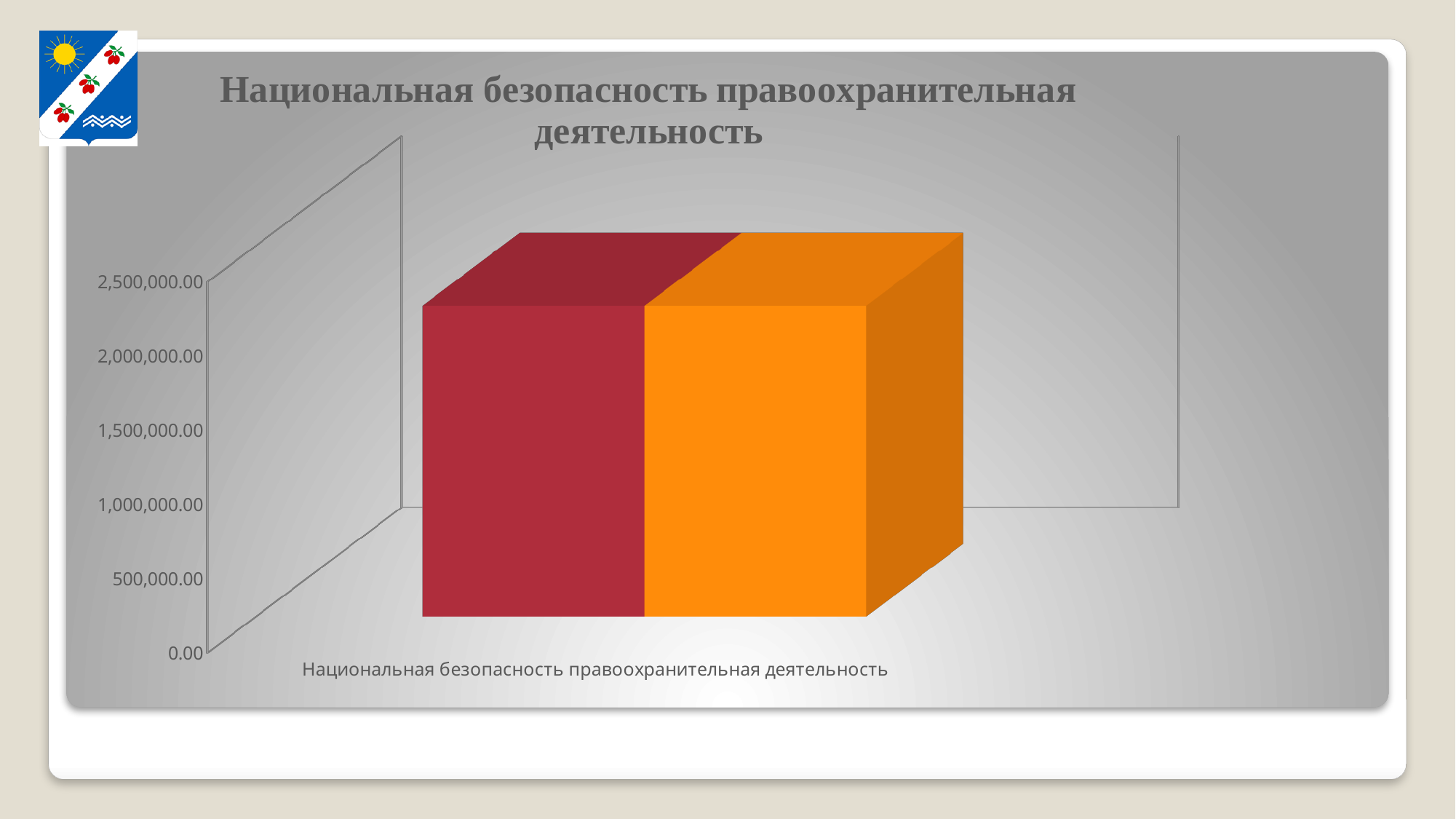
Does the chart display a legend? No How many categories are shown on the x axis of the chart? 1 What is the category label shown on the x axis? Национальная безопасность правоохранительная деятельность Is the value of the orange bar greater or less than 1,500,000.00? greater What is the title of the chart? Национальная безопасность правоохранительная деятельность Is the value of the red bar greater or less than 1,000,000.00? greater How many bars are plotted in the chart? 2 What colours are the two bars in the chart? red and orange What kind of chart is shown on the slide? bar chart What is the lowest tick value shown on the vertical axis? 0.00 What is the highest tick value shown on the vertical axis? 2,500,000.00